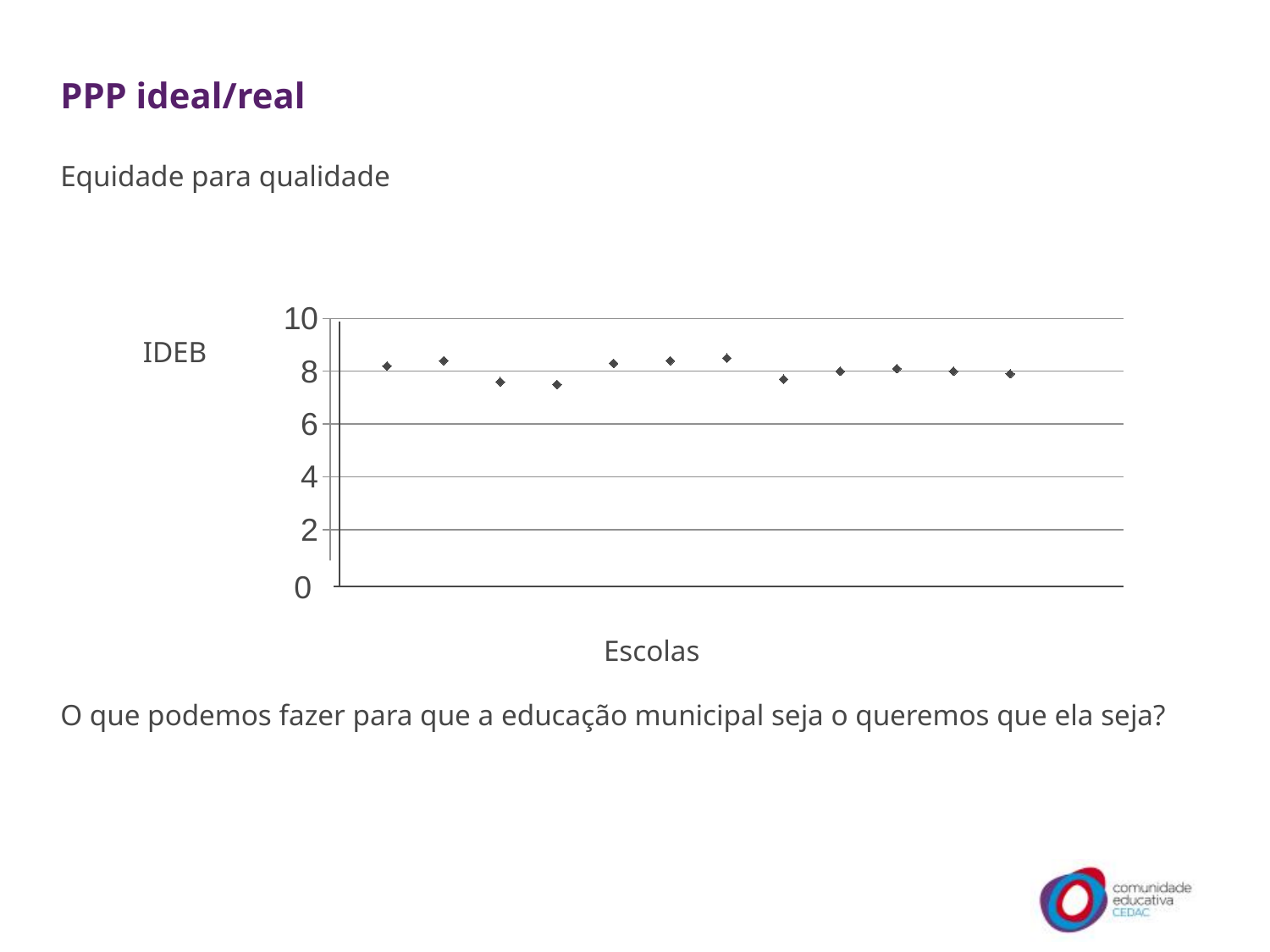
Is the value of the seventh point from the left greater or less than 8? greater Is the value of the fourth point from the left greater or less than 8? less How many data points are plotted in the chart? 12 What is the highest tick value shown on the vertical axis? 10 What kind of chart is shown on the slide? scatter chart Are all the plotted points greater or less than 6? greater What is the label on the vertical axis of the chart? IDEB What is the label on the horizontal axis of the chart? Escolas